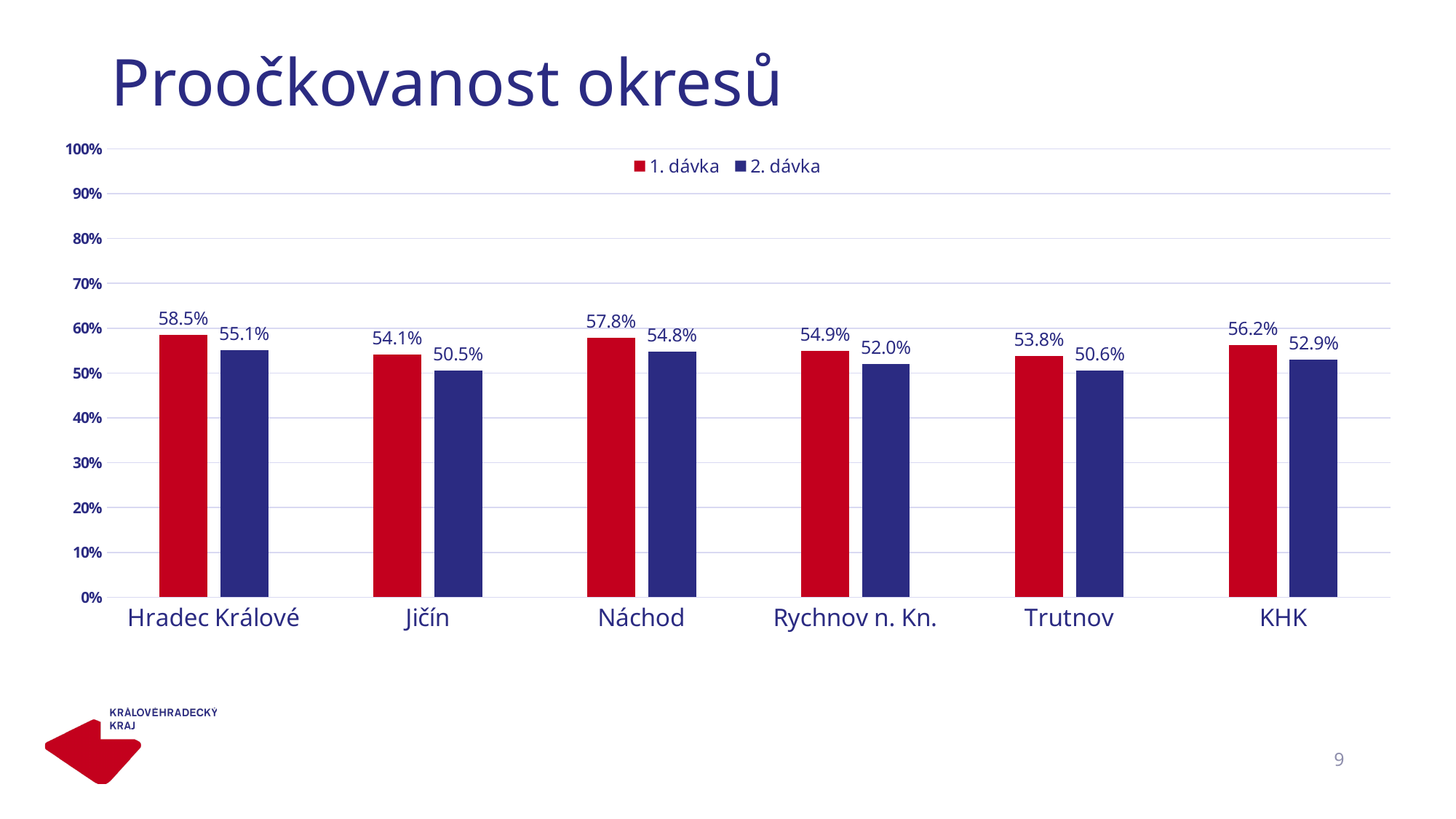
Is the value of 2. dávka for Trutnov greater or less than 60%? less What is the difference between 1. dávka and 2. dávka for Náchod? 3.0% What is the value of 2. dávka for KHK? 52.9% Which category has the lowest value for 2. dávka? Jičín What is the value of 1. dávka for Hradec Králové? 58.5% Which is larger: 1. dávka for Trutnov or 1. dávka for Rychnov n. Kn.? Rychnov n. Kn. How many series does the legend list? 2 How many categories are shown on the x axis? 6 What is the value of 2. dávka for Jičín? 50.5% What is the title of the slide? Proočkovanost okresů Which category has the highest value for 1. dávka? Hradec Králové What kind of chart is shown on the slide? bar chart